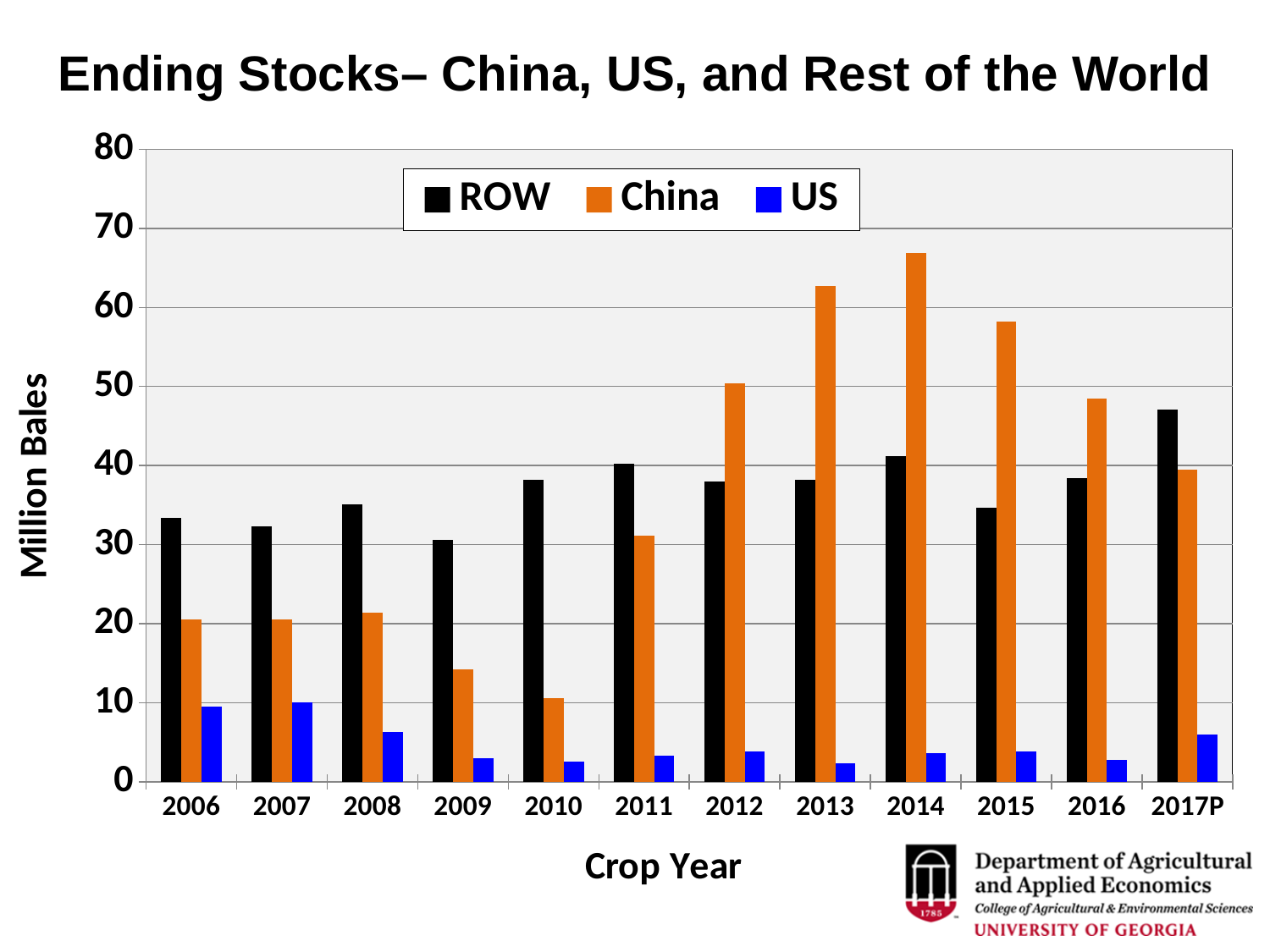
Is the value for ROW in 2017P greater or less than 40? greater What is the label on the y axis? Million Bales Is the value for China in 2009 greater or less than 20? less In 2011, which is larger, ROW or China? ROW Is the value for China in 2013 greater or less than 60? greater In which crop year is the China ending stock lowest? 2010 What kind of chart is shown on the slide? bar chart In which crop year is the China ending stock highest? 2014 How many crop years are shown on the x axis? 12 How many series does the legend list? 3 In which crop year is the ROW ending stock highest? 2017P Do the China values rise or fall from 2014 to 2017P? fall